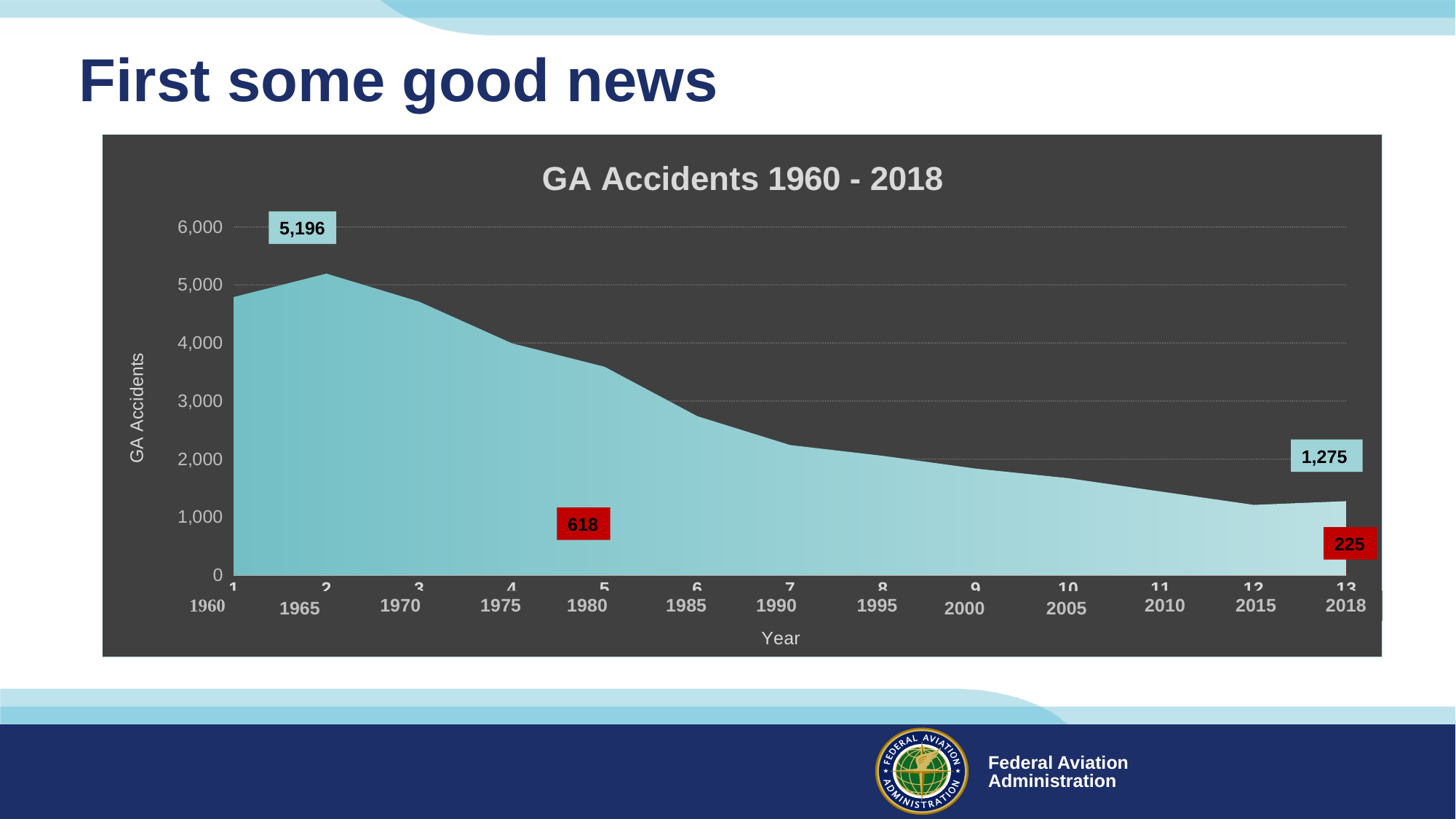
What kind of chart is shown on the slide? area chart What value is printed in the label at the peak of the chart? 5,196 Is the value for 1960 greater or less than 4,000? greater What is the title of the chart? GA Accidents 1960 - 2018 Which year has the larger value, 1970 or 1990? 1970 What value is printed in the light blue label at the right end of the chart, near 2018? 1,275 Is the value for 1980 greater or less than 3,000? greater Is the value for 2000 greater or less than 2,000? less In which year does the chart reach its highest value? 1965 What is the label on the vertical axis? GA Accidents How many year points are plotted along the x axis? 13 Overall, do GA accidents rise or fall from 1960 to 2018? fall